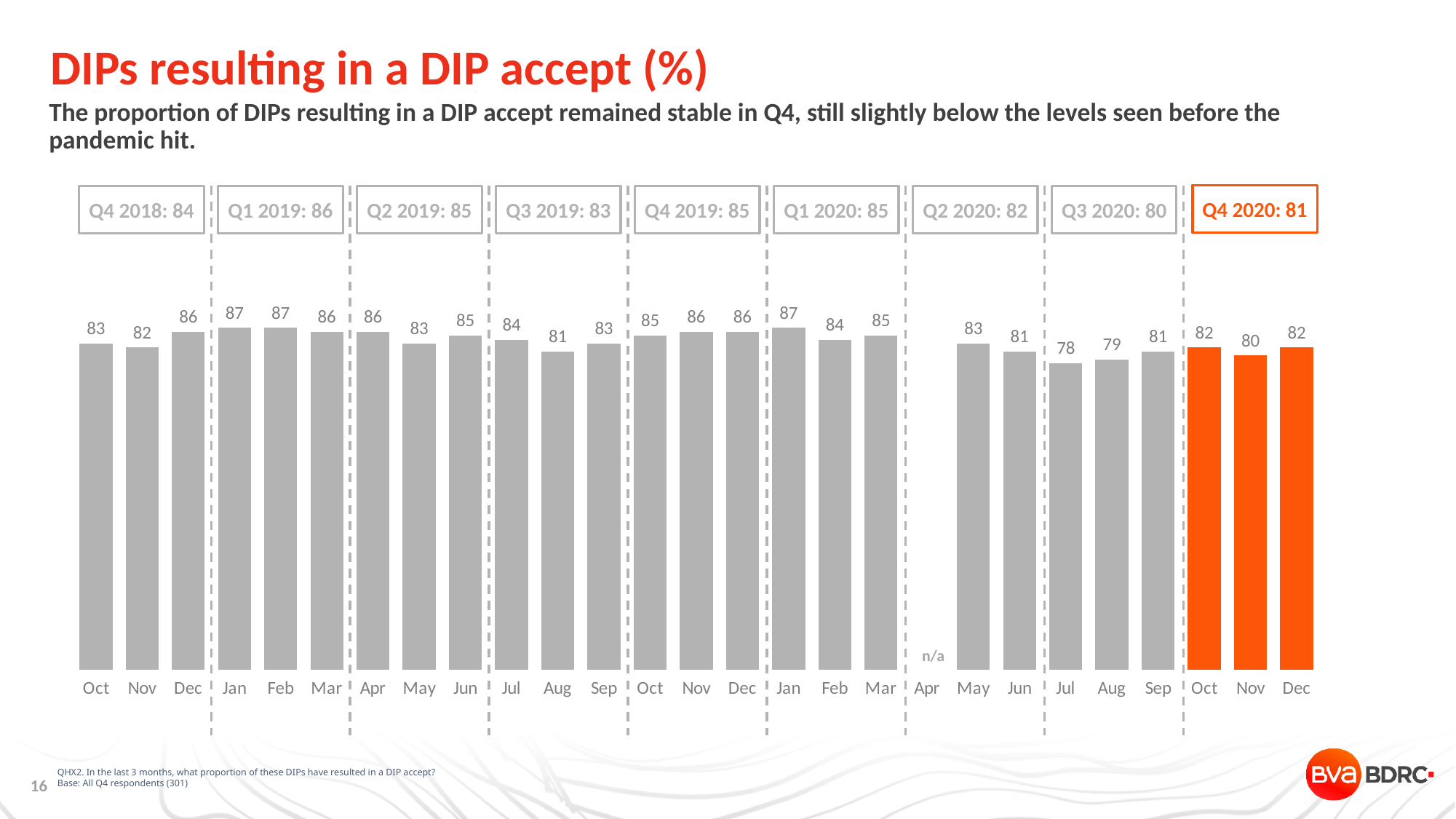
What is the difference between the Jan value in Q1 2020 and the Jul value in Q3 2020? 9 What is the highest value shown on any bar in the chart? 87 How many quarterly summary boxes are shown above the chart? 9 What is the value for Dec in the Q4 2020 section (the orange bars)? 82 What is the quarterly figure shown in the box for Q4 2020? 81 What is the quarterly figure shown in the box for Q1 2019? 86 Which month is marked n/a with no bar on the chart? Apr (Q2 2020) What type of chart is shown on the slide? Bar chart What is the value for Jul in the Q3 2020 section of the chart? 78 Which month has the lowest value on the chart? Jul (Q3 2020) What is the value for Feb in the Q1 2019 section of the chart? 87 Which is larger: the Nov value in Q4 2019 or the Nov value in Q4 2020? Nov in Q4 2019